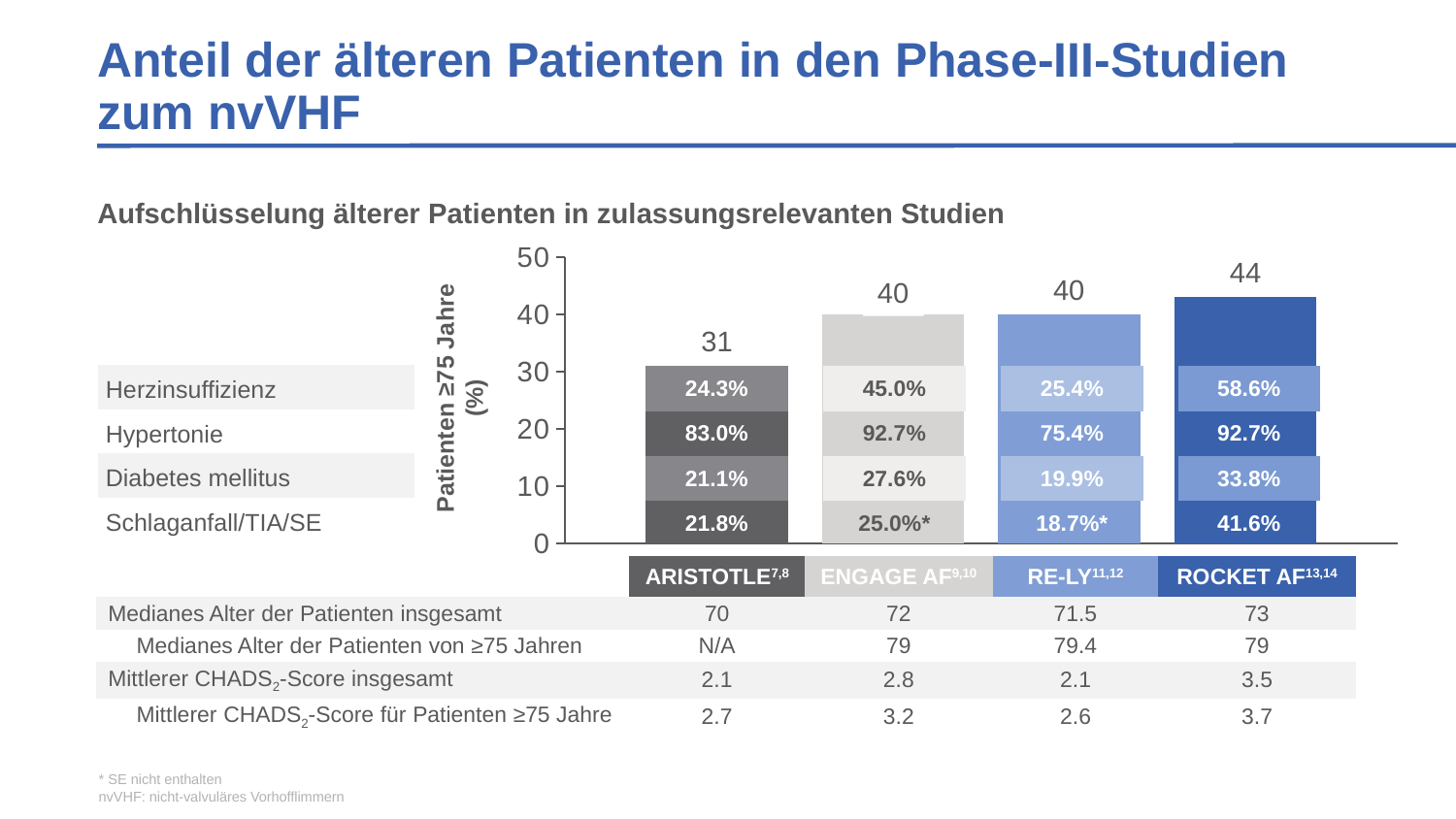
What is the label of the y-axis of the chart? Patienten ≥75 Jahre (%) What is the Hypertonie percentage shown in the RE-LY bar? 75.4% What is the difference in the share of patients ≥75 years between ROCKET AF and ARISTOTLE? 13 How many studies (bars) are shown in the chart? 4 What is the percentage of patients ≥75 years in the ENGAGE AF study? 40 What is the percentage of patients ≥75 years in the ROCKET AF study? 44 What type of chart is shown on the slide? bar chart What is the Herzinsuffizienz percentage shown in the ROCKET AF bar? 58.6% Which study has the lowest share of patients ≥75 years? ARISTOTLE Which study has the highest share of patients ≥75 years? ROCKET AF Which study has a larger share of patients ≥75 years, ARISTOTLE or RE-LY? RE-LY What is the percentage of patients ≥75 years in the ARISTOTLE study? 31